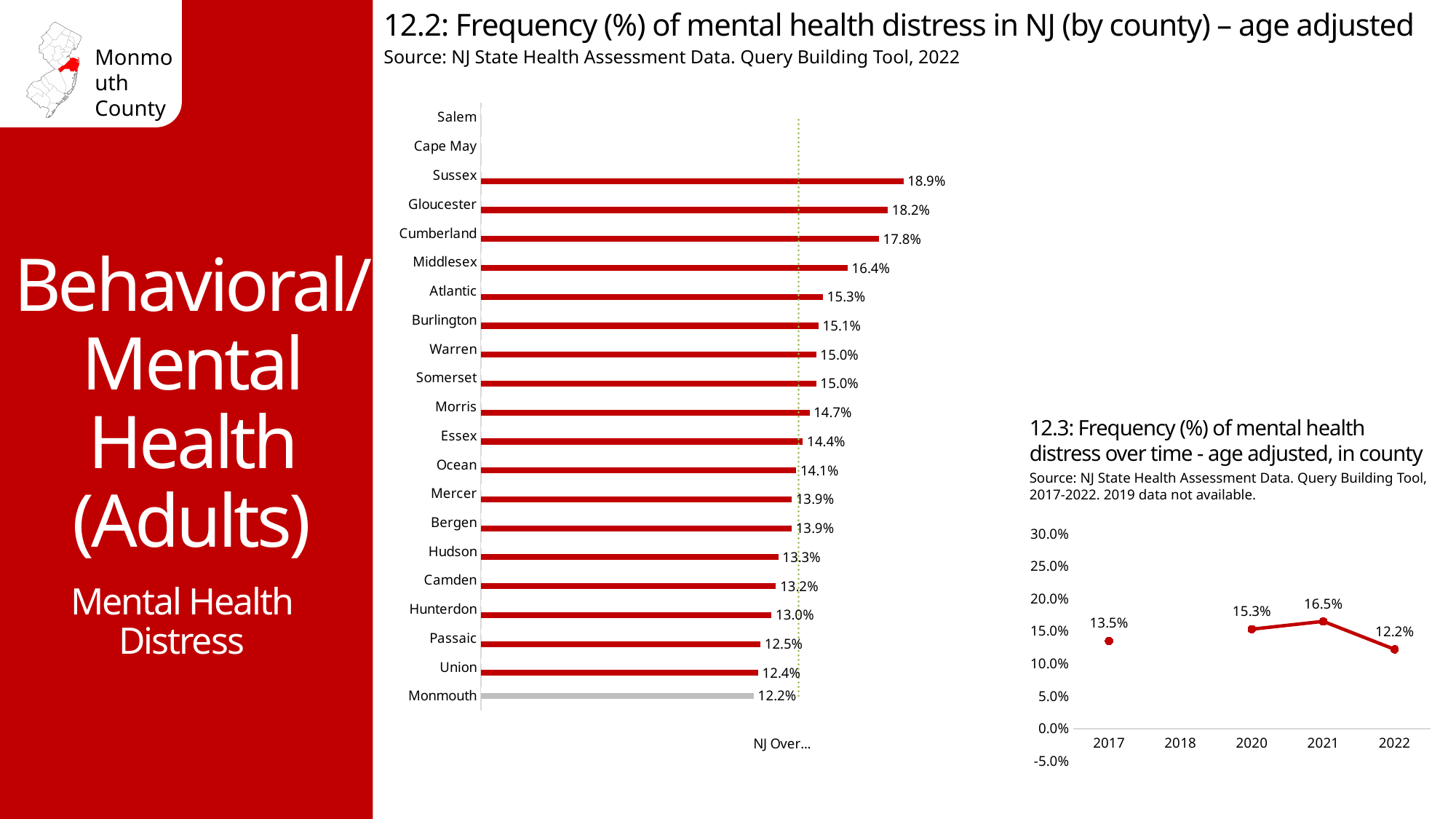
In chart 12.2, which county has the lowest plotted value? Monmouth In chart 12.3, how many data points are plotted? 4 In chart 12.2, what is the difference between the values for Gloucester and Cumberland? 0.4% In chart 12.2, what is the value for Hunterdon? 13.0% In chart 12.2, what kind of chart is shown? Bar chart In chart 12.3, which year has the highest value? 2021 In chart 12.2, which county has the highest plotted value? Sussex In chart 12.2, what is the value for Sussex? 18.9% In chart 12.3, what is the value for 2021? 16.5% In chart 12.2, what is the value for Monmouth? 12.2% In chart 12.3, what is the difference between the values for 2021 and 2022? 4.3% In chart 12.2, which is larger, the value for Middlesex or the value for Atlantic? Middlesex